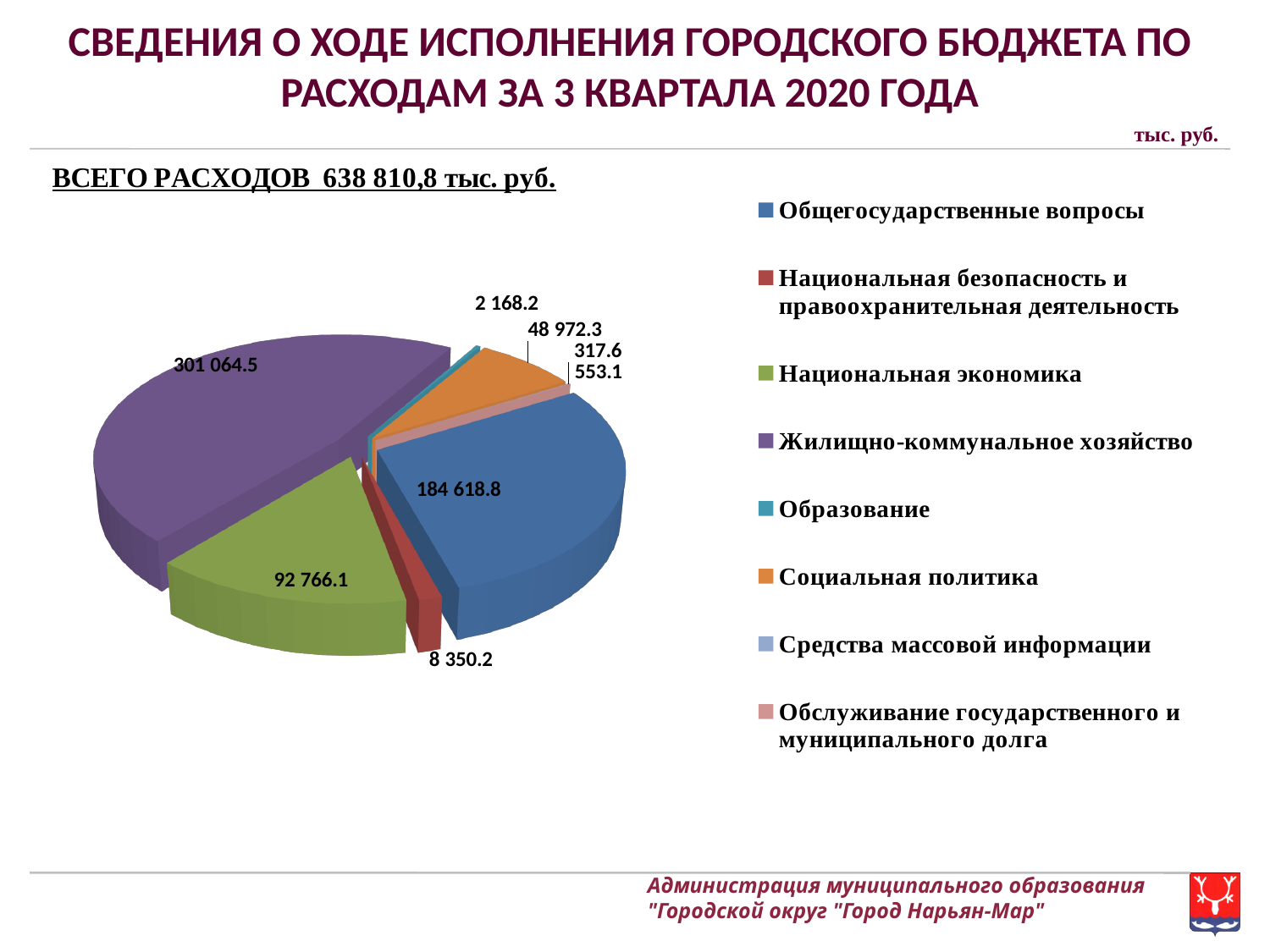
What is the difference between Жилищно-коммунальное хозяйство and Общегосударственные вопросы? 116 445.7 What total expenditure (ВСЕГО РАСХОДОВ) is stated above the chart? 638 810,8 тыс. руб. What is the value for Социальная политика? 48 972.3 What is the value for Национальная безопасность и правоохранительная деятельность? 8 350.2 How many categories does the legend of the pie chart list? 8 What is the value for Образование? 2 168.2 What is the value for Общегосударственные вопросы? 184 618.8 What is the value for Жилищно-коммунальное хозяйство? 301 064.5 What kind of chart is shown on the slide? Pie chart What is the value for Национальная экономика? 92 766.1 Which category has the largest slice of the pie? Жилищно-коммунальное хозяйство Which is larger, Национальная экономика or Социальная политика? Национальная экономика